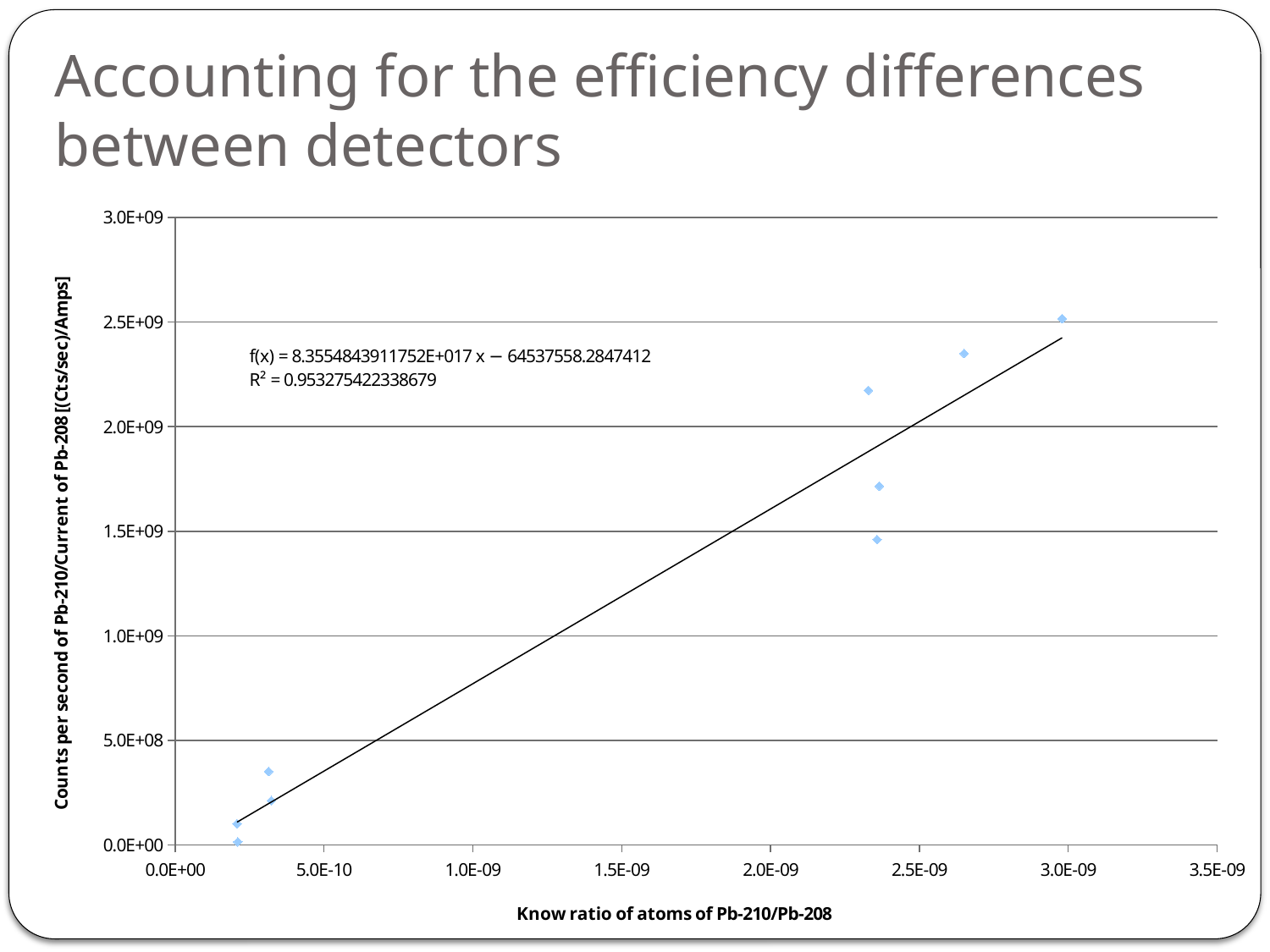
Are the y values of the points near 3.0E-10 on the x axis greater or less than 5.0E+08? less What is the intercept term in the trendline equation f(x) shown on the chart? − 64537558.2847412 Is the y value of the point at about 2.65E-09 on the x axis greater or less than 2.0E+09? greater What is the R² value shown for the trendline? 0.953275422338679 Do the plotted values generally rise or fall as the known ratio of atoms of Pb-210/Pb-208 increases? rise What is the slope coefficient in the trendline equation f(x) shown on the chart? 8.3554843911752E+017 What is the maximum value shown on the y axis? 3.0E+09 What kind of chart is shown on the slide? scatter plot Is the y value of the lowest point near 2.35E-09 on the x axis greater or less than 1.5E+09? less How many data points are plotted on the chart? 9 What is the title of the x axis? Know ratio of atoms of Pb-210/Pb-208